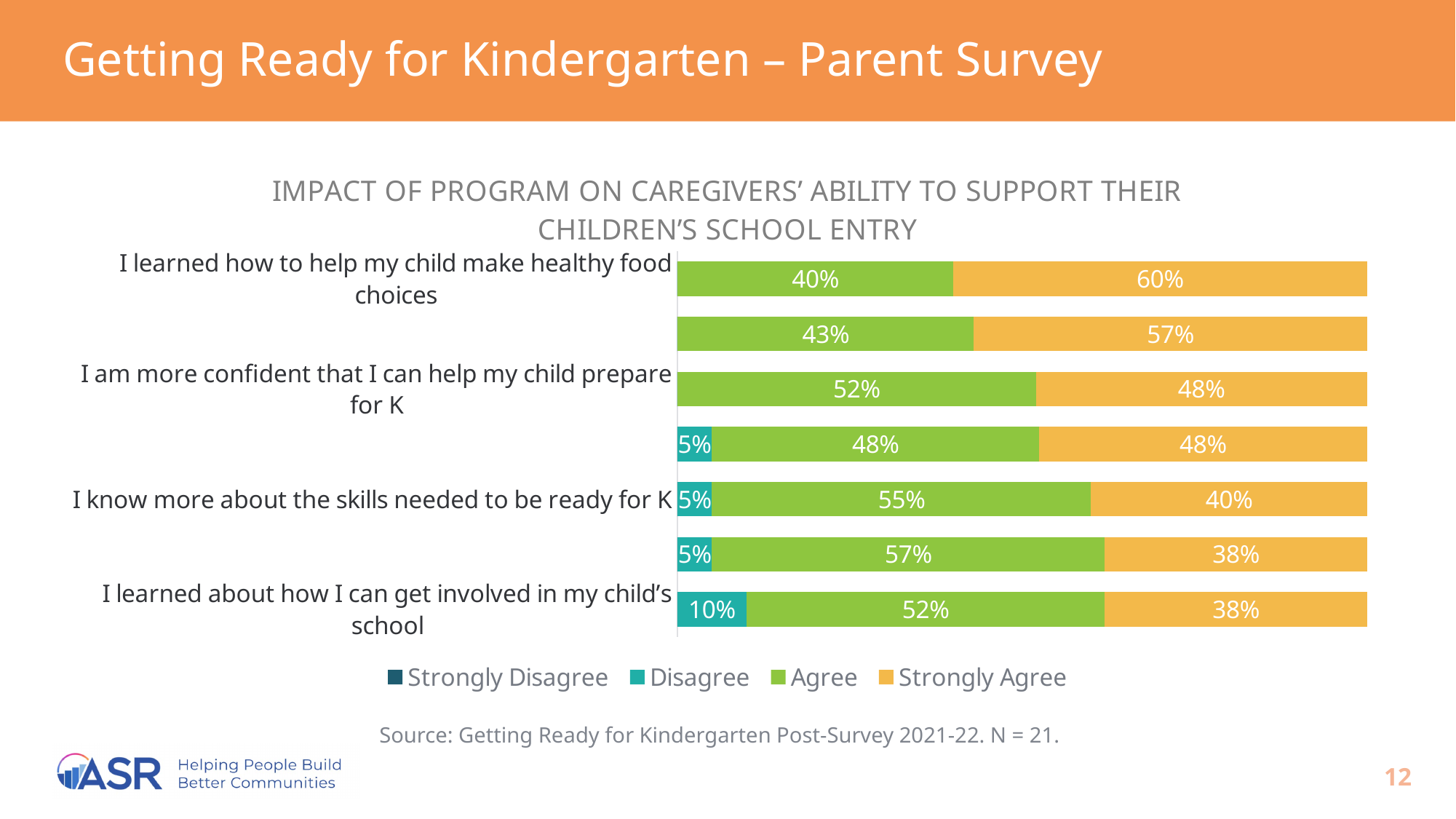
What percentage of caregivers strongly agreed that they learned how to help their child make healthy food choices? 60% What percentage of caregivers agreed with the statement 'I am more confident that I can help my child prepare for K'? 52% How many bars are shown in the chart? 7 For 'I know more about the skills needed to be ready for K', which is larger: the Agree share or the Strongly Agree share? Agree Which labeled statement has the highest Strongly Agree percentage? I learned how to help my child make healthy food choices How many response categories does the legend list? 4 What type of chart is shown on the slide? Stacked bar chart What percentage of caregivers strongly agreed with the statement 'I know more about the skills needed to be ready for K'? 40% What is the combined Agree and Strongly Agree percentage for 'I learned about how I can get involved in my child's school'? 90% What percentage of caregivers disagreed with the statement 'I learned about how I can get involved in my child's school'? 10% Which labeled statement has the highest Disagree percentage? I learned about how I can get involved in my child's school What is the difference between the Strongly Agree percentages for 'I learned how to help my child make healthy food choices' and 'I learned about how I can get involved in my child's school'? 22%